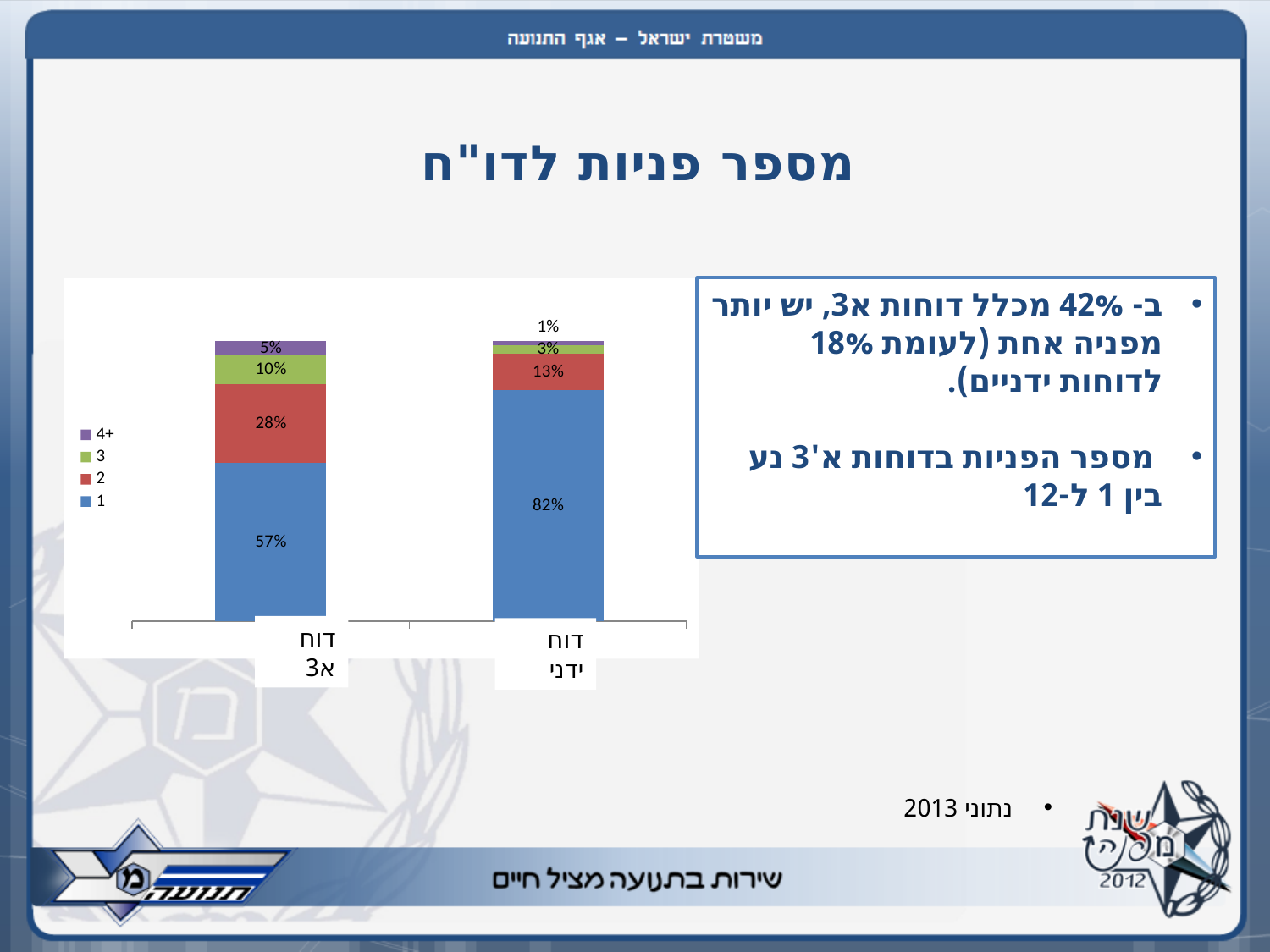
What is the total of the stacked bar for "דוח א3"? 100% What is the difference between the series "1" values for "דוח ידני" and "דוח א3"? 25% What is the value of series "3" for "דוח א3"? 10% What is the value of series "4+" for "דוח ידני"? 1% What is the value of series "1" for "דוח ידני"? 82% How many categories are shown on the x axis of the chart? 2 What is the value of series "1" for "דוח א3"? 57% How many series does the chart's legend list? 4 Which legend entry is shown in blue? 1 What is the value of series "2" for "דוח א3"? 28% Which category has the higher value for series "2", "דוח א3" or "דוח ידני"? דוח א3 What kind of chart is shown on the slide? stacked bar chart